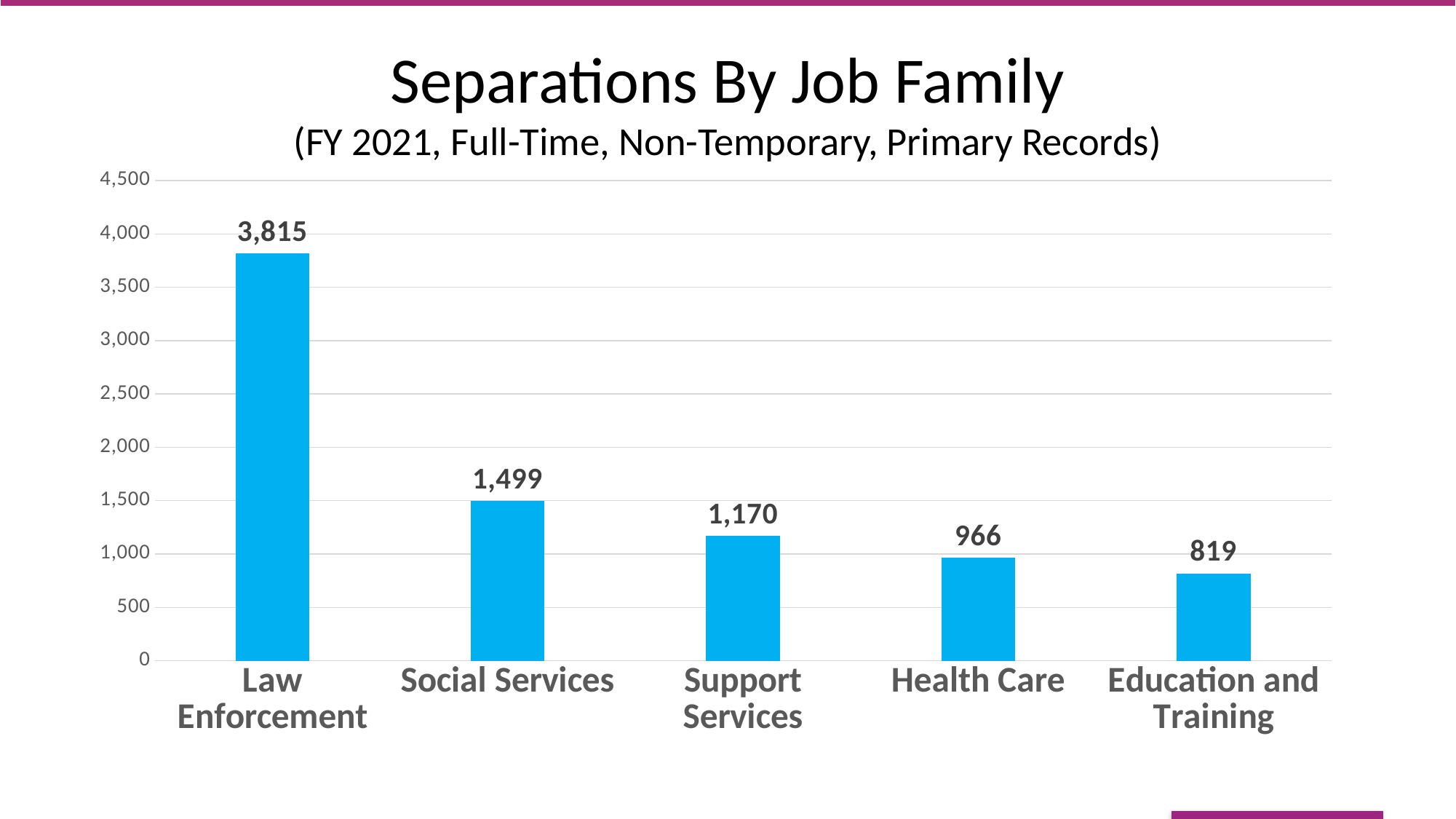
Which job family has the highest number of separations? Law Enforcement Which job family has the lowest number of separations? Education and Training Which has more separations, Support Services or Health Care? Support Services Do the values rise or fall from left to right across the job families? Fall What type of chart is shown on the slide? Bar chart What is the number of separations for Social Services? 1,499 What is the difference in separations between Support Services and Health Care? 204 What is the number of separations for Health Care? 966 What is the difference in separations between Law Enforcement and Social Services? 2,316 What is the number of separations for Education and Training? 819 What is the number of separations for Law Enforcement? 3,815 How many job families are shown in the chart? 5